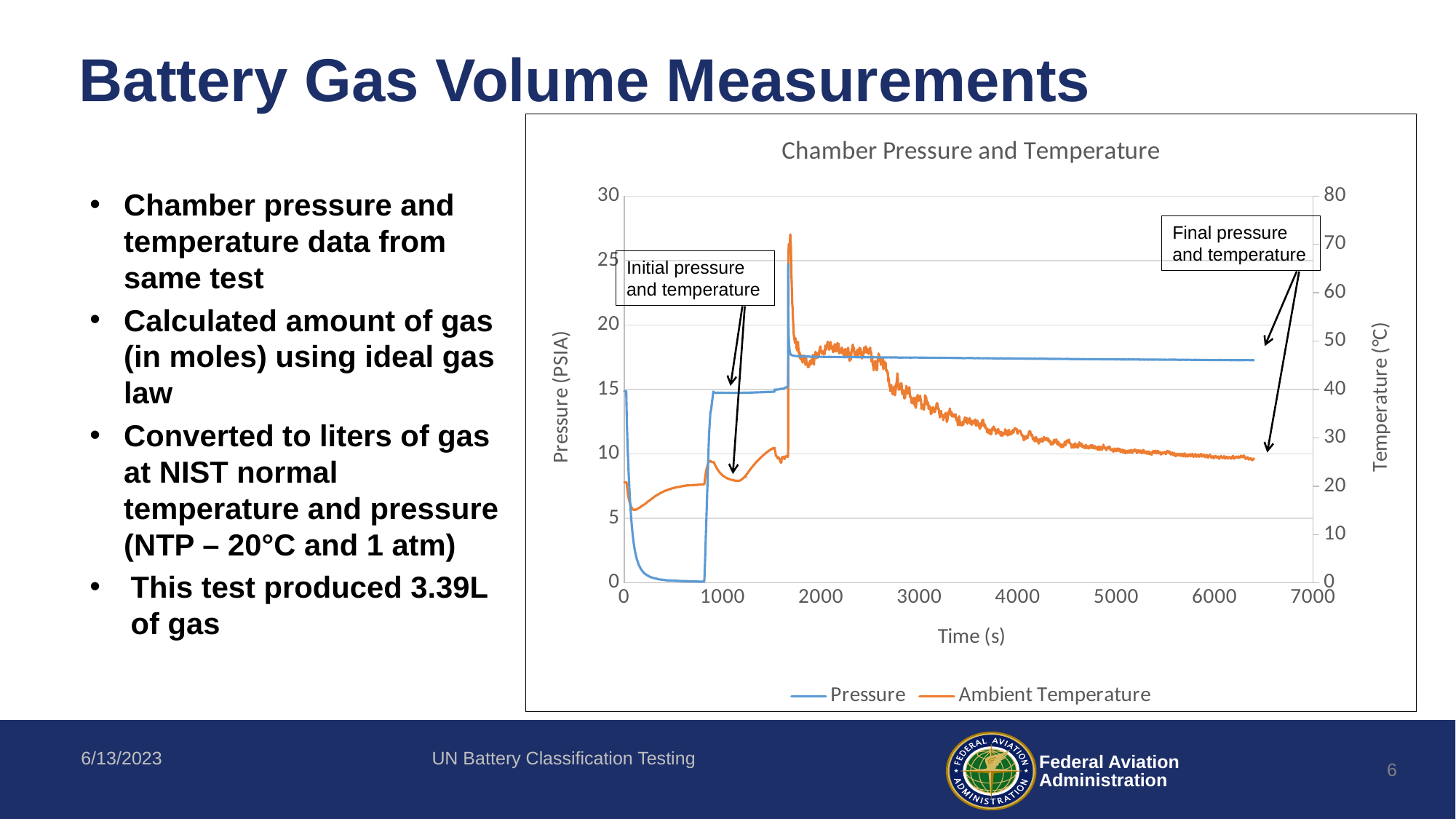
Does the Ambient Temperature rise or fall between 2000 s and 6000 s? fall Is the Pressure value at 4000 s greater or less than 15 PSIA? greater Is the Pressure value at around 1200 s greater or less than 10 PSIA? greater What is the title of the chart? Chamber Pressure and Temperature How many series does the chart legend list? 2 What is the label of the x axis of the chart? Time (s) Is the Ambient Temperature value at 3000 s greater or less than 30 °C? greater What kind of chart is shown on the slide? line chart Does the Pressure rise or fall between 0 s and about 500 s? fall